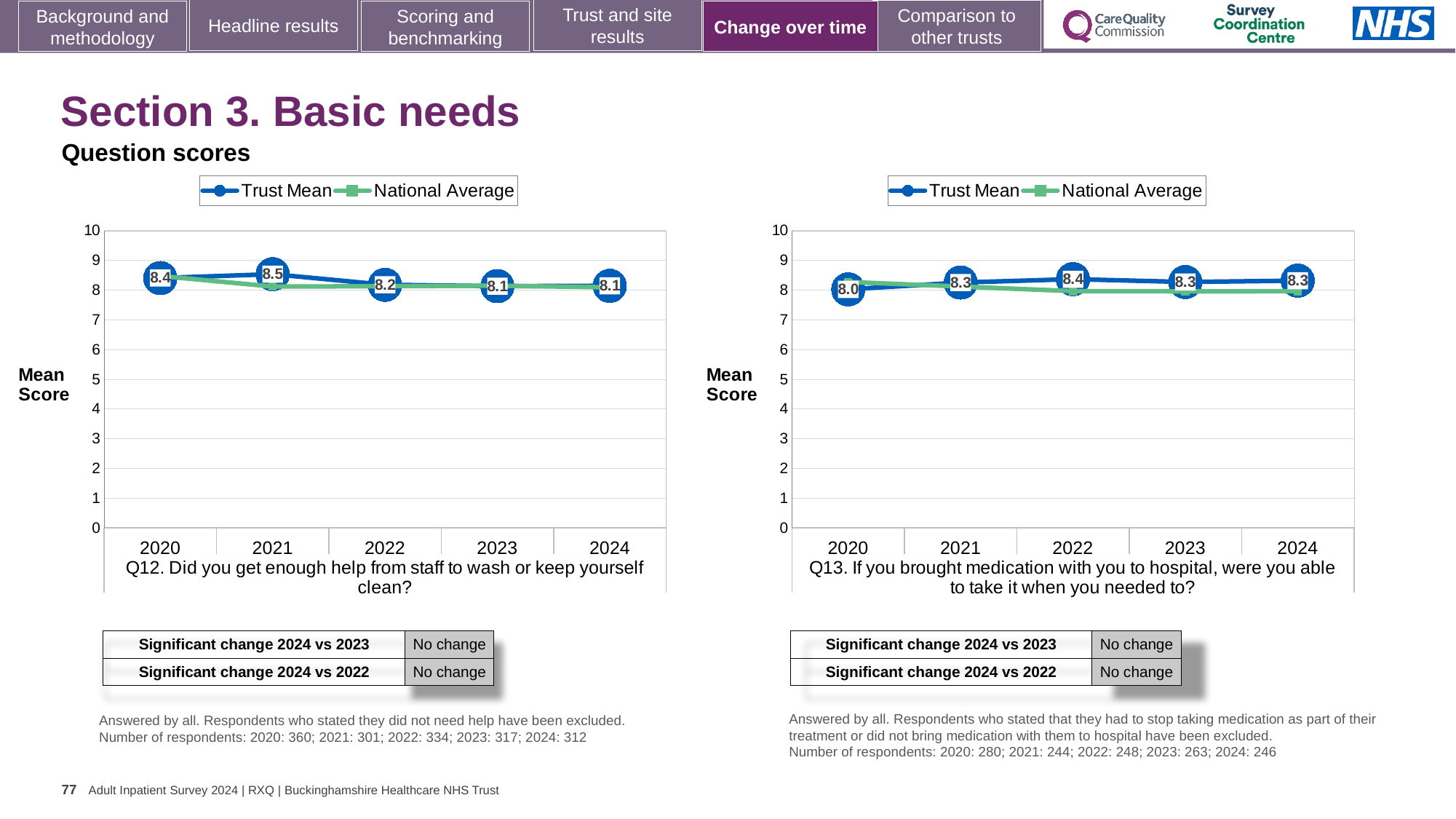
In the Q12 chart (left), is the National Average value for 2020 greater or less than 5? greater In the Q13 chart (right), which year has the highest Trust Mean score? 2022 In the Q12 chart (left), which year has the highest Trust Mean score? 2021 How many years are shown on the x axis of the Q13 chart (right)? 5 In the Q12 chart (left), what is the Trust Mean score for 2021? 8.5 In the Q12 chart (left), what is the difference between the Trust Mean scores for 2021 and 2024? 0.4 How many series does the legend of the Q12 chart (left) list? 2 What type of chart is used for Q13 (right)? Line chart In the Q12 chart (left), is the Trust Mean score higher in 2020 or in 2023? 2020 In the Q13 chart (right), what is the difference between the Trust Mean scores for 2022 and 2020? 0.4 In the Q13 chart (right), which year has the lowest Trust Mean score? 2020 In the Q13 chart (right), what is the Trust Mean score for 2020? 8.0